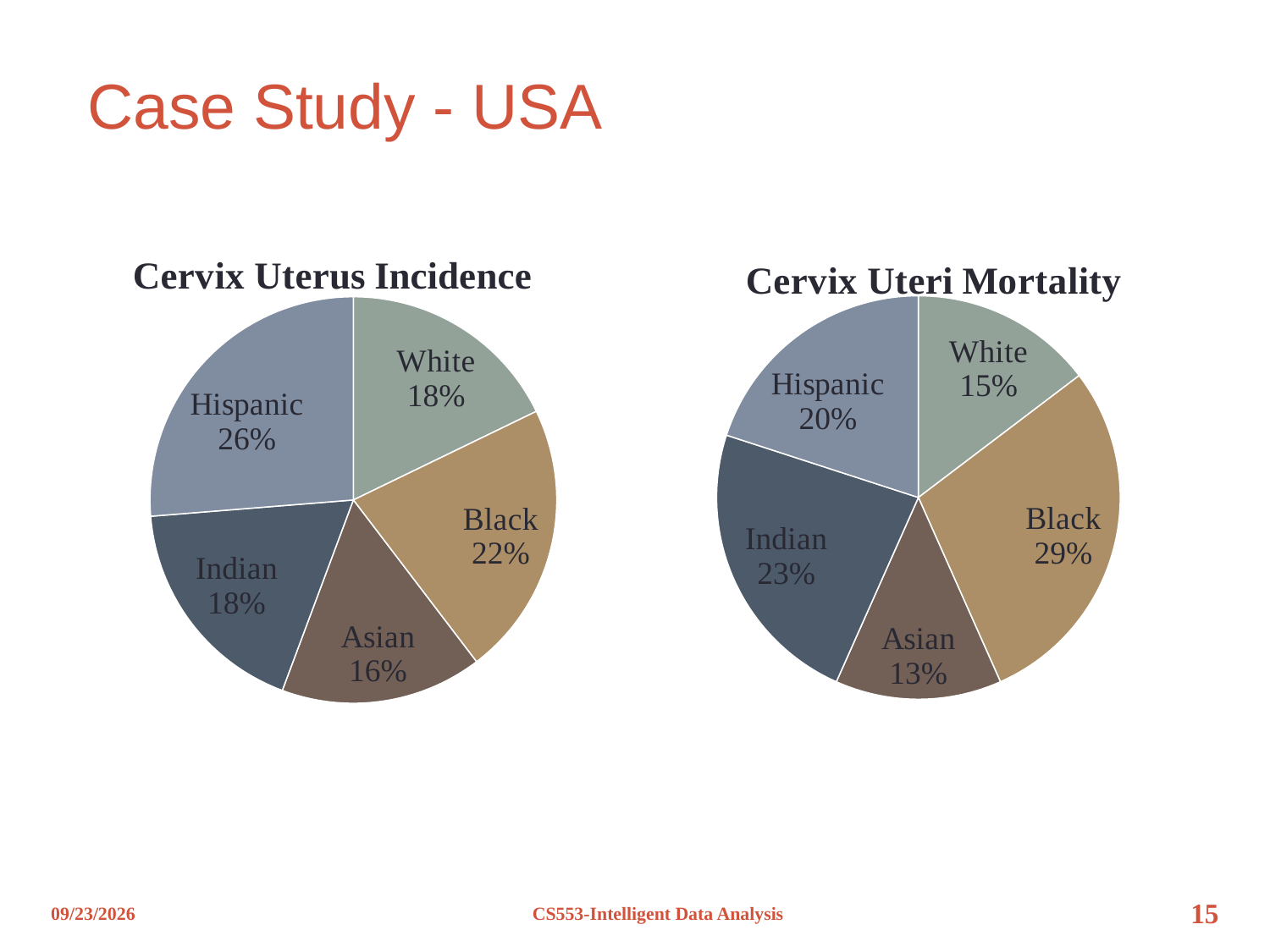
In the Cervix Uteri Mortality chart, which category has the smallest share? Asian In the Cervix Uteri Mortality chart, what is the difference between the Black and White shares? 14% In the Cervix Uterus Incidence chart, which category has the largest share? Hispanic In the Cervix Uterus Incidence chart, which category has the smallest share? Asian In the Cervix Uteri Mortality chart, which category has the largest share? Black In the Cervix Uteri Mortality chart, what is the value for Asian? 13% What is the title of the chart on the left of the slide? Cervix Uterus Incidence In the Cervix Uteri Mortality chart, what is the value for Black? 29% What kind of chart is the Cervix Uteri Mortality chart? Pie chart In the Cervix Uterus Incidence chart, which is larger, the share for Black or the share for Indian? Black How many categories does the Cervix Uterus Incidence chart show? 5 In the Cervix Uterus Incidence chart, what is the value for Hispanic? 26%